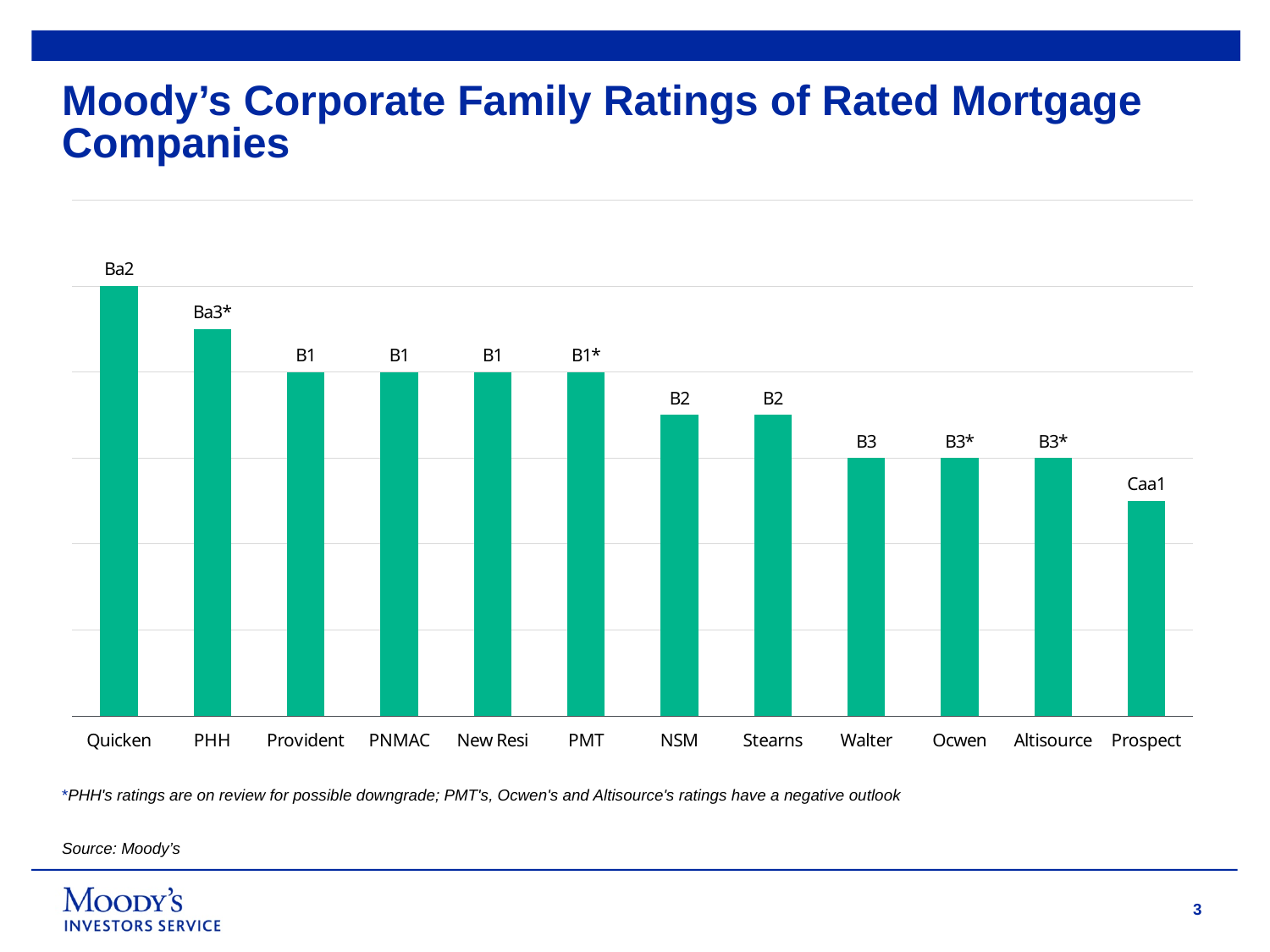
What rating label is shown for Prospect? Caa1 How many companies are shown on the x axis of the chart? 12 Do the bars rise or fall moving from left to right along the x axis? Fall What rating label is shown for Ocwen? B3* Which bar is taller, PNMAC or NSM? PNMAC What rating label is shown for PHH? Ba3* What rating label is shown for Stearns? B2 What type of chart is shown on the slide? Bar chart Which bar is taller, Walter or PHH? PHH Which company has the shortest bar (lowest rating) in the chart? Prospect What is the Moody's corporate family rating shown for Quicken? Ba2 Which company has the tallest bar (highest rating) in the chart? Quicken